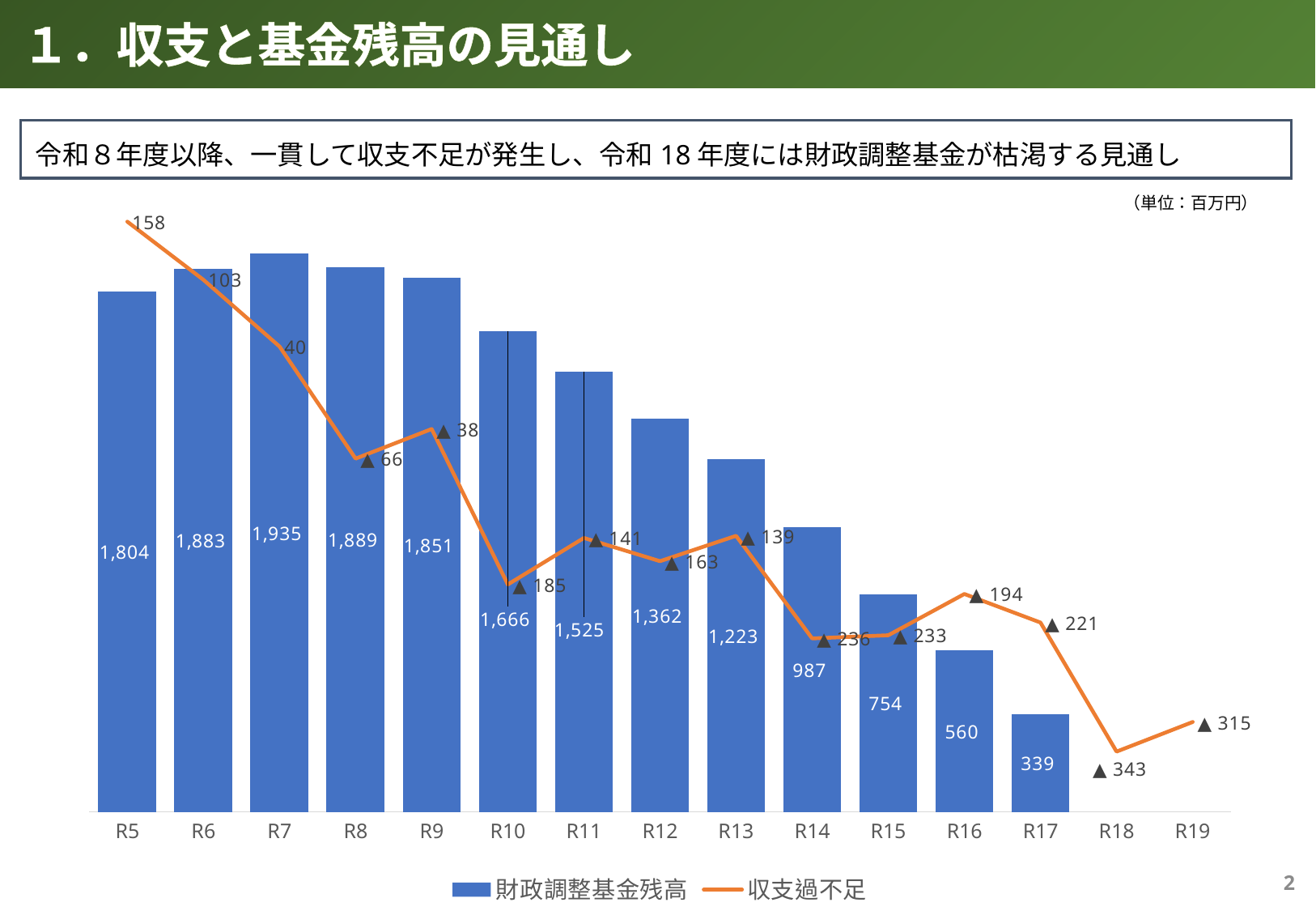
What is the 収支過不足 value for R10? ▲ 185 How many series does the legend list? 2 What is the 財政調整基金残高 value for R14? 987 Which is larger, the 財政調整基金残高 for R12 or for R13? R12 What kind of chart is this? Combined bar and line chart What is the difference between the 財政調整基金残高 for R5 and R17? 1,465 Which year has the lowest 財政調整基金残高 among the bars shown? R17 What is the 財政調整基金残高 value for R7? 1,935 How many years are shown on the x axis? 15 Which year has the highest 財政調整基金残高? R7 Does the 財政調整基金残高 rise or fall from R7 to R17? Fall What is the 収支過不足 value for R5? 158